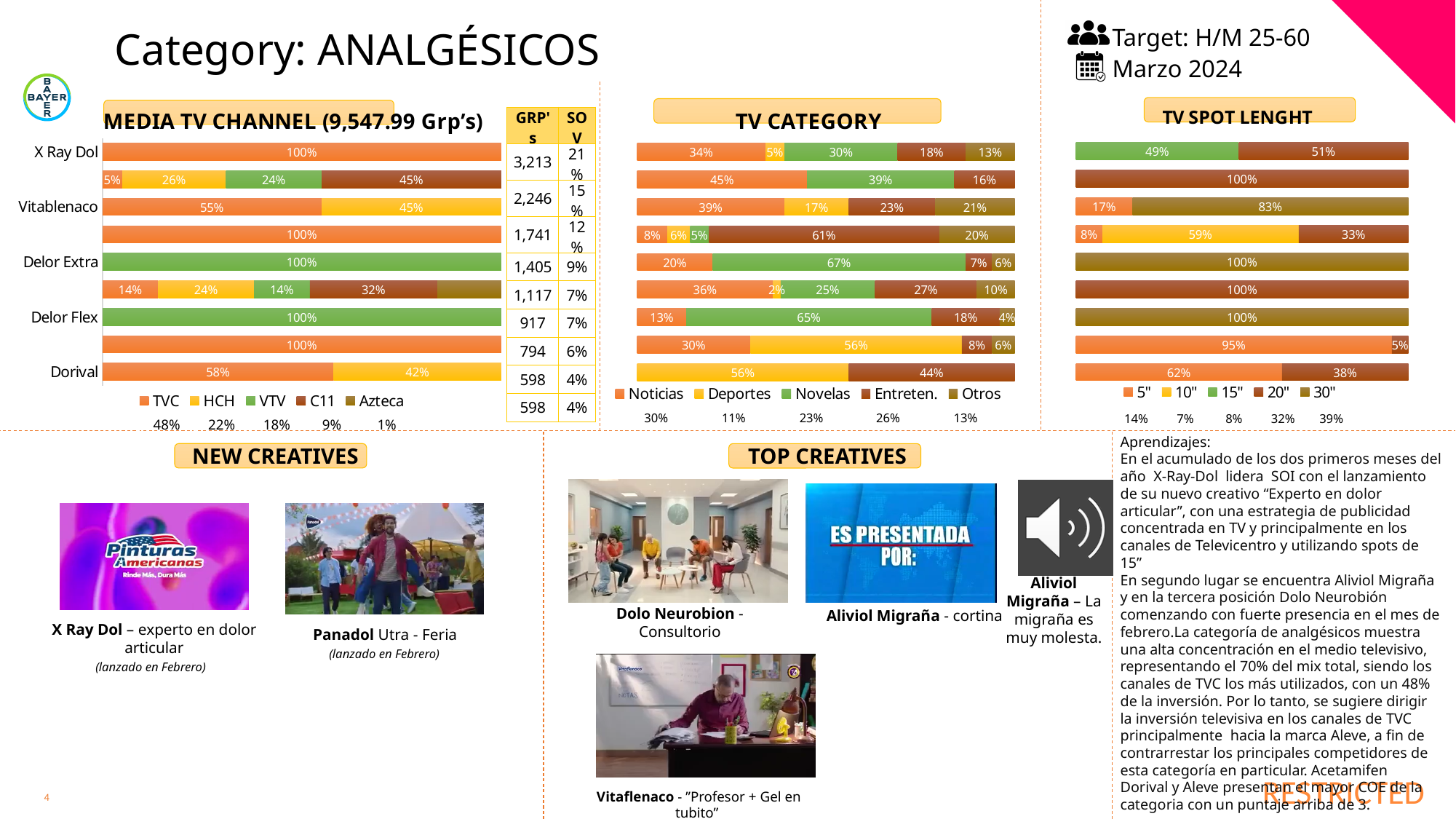
What are the legend entries of the TV SPOT LENGHT chart? 5", 10", 15", 20", 30" What kind of chart is the MEDIA TV CHANNEL chart? bar chart How many bars are plotted in the MEDIA TV CHANNEL chart? 9 In the MEDIA TV CHANNEL chart, which is larger for Vitablenaco, the TVC share or the HCH share? TVC How many series does the legend of the MEDIA TV CHANNEL chart list? 5 In the MEDIA TV CHANNEL chart, what is the HCH share for Dorival? 42% In the MEDIA TV CHANNEL chart, what is the TVC share for X Ray Dol? 100% In the MEDIA TV CHANNEL chart, what is the TVC share for Vitablenaco? 55% How many series does the legend of the TV CATEGORY chart list? 5 What GRP's total is shown in the title of the MEDIA TV CHANNEL chart? 9,547.99 In the MEDIA TV CHANNEL chart, what is the VTV share for Delor Extra? 100% In the MEDIA TV CHANNEL chart, what is the difference between the TVC share and the HCH share for Dorival? 16%